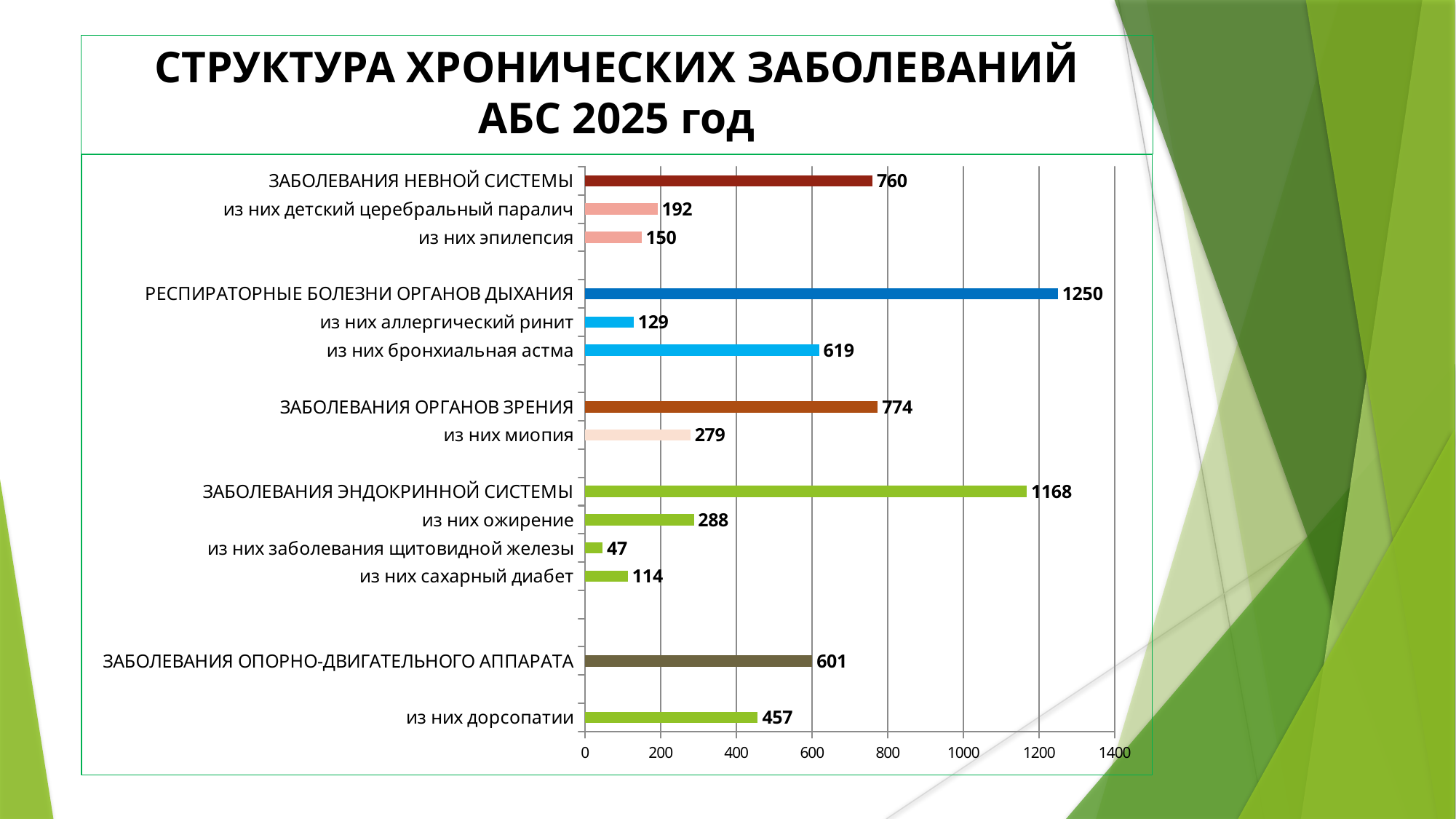
Which category has the lowest value? из них заболевания щитовидной железы What is the value for ЗАБОЛЕВАНИЯ ЭНДОКРИННОЙ СИСТЕМЫ? 1168 What is the value for из них дорсопатии? 457 What is the difference between the values for ЗАБОЛЕВАНИЯ НЕВНОЙ СИСТЕМЫ and из них детский церебральный паралич? 568 Which category has the highest value? РЕСПИРАТОРНЫЕ БОЛЕЗНИ ОРГАНОВ ДЫХАНИЯ What type of chart is shown on the slide? bar chart Which is larger: the value for ЗАБОЛЕВАНИЯ ОРГАНОВ ЗРЕНИЯ or the value for ЗАБОЛЕВАНИЯ НЕВНОЙ СИСТЕМЫ? ЗАБОЛЕВАНИЯ ОРГАНОВ ЗРЕНИЯ How many bars are plotted in the chart? 14 What is the title of the slide? СТРУКТУРА ХРОНИЧЕСКИХ ЗАБОЛЕВАНИЙ АБС 2025 год What is the value for из них бронхиальная астма? 619 What is the value for РЕСПИРАТОРНЫЕ БОЛЕЗНИ ОРГАНОВ ДЫХАНИЯ? 1250 What is the difference between the values for РЕСПИРАТОРНЫЕ БОЛЕЗНИ ОРГАНОВ ДЫХАНИЯ and ЗАБОЛЕВАНИЯ ЭНДОКРИННОЙ СИСТЕМЫ? 82